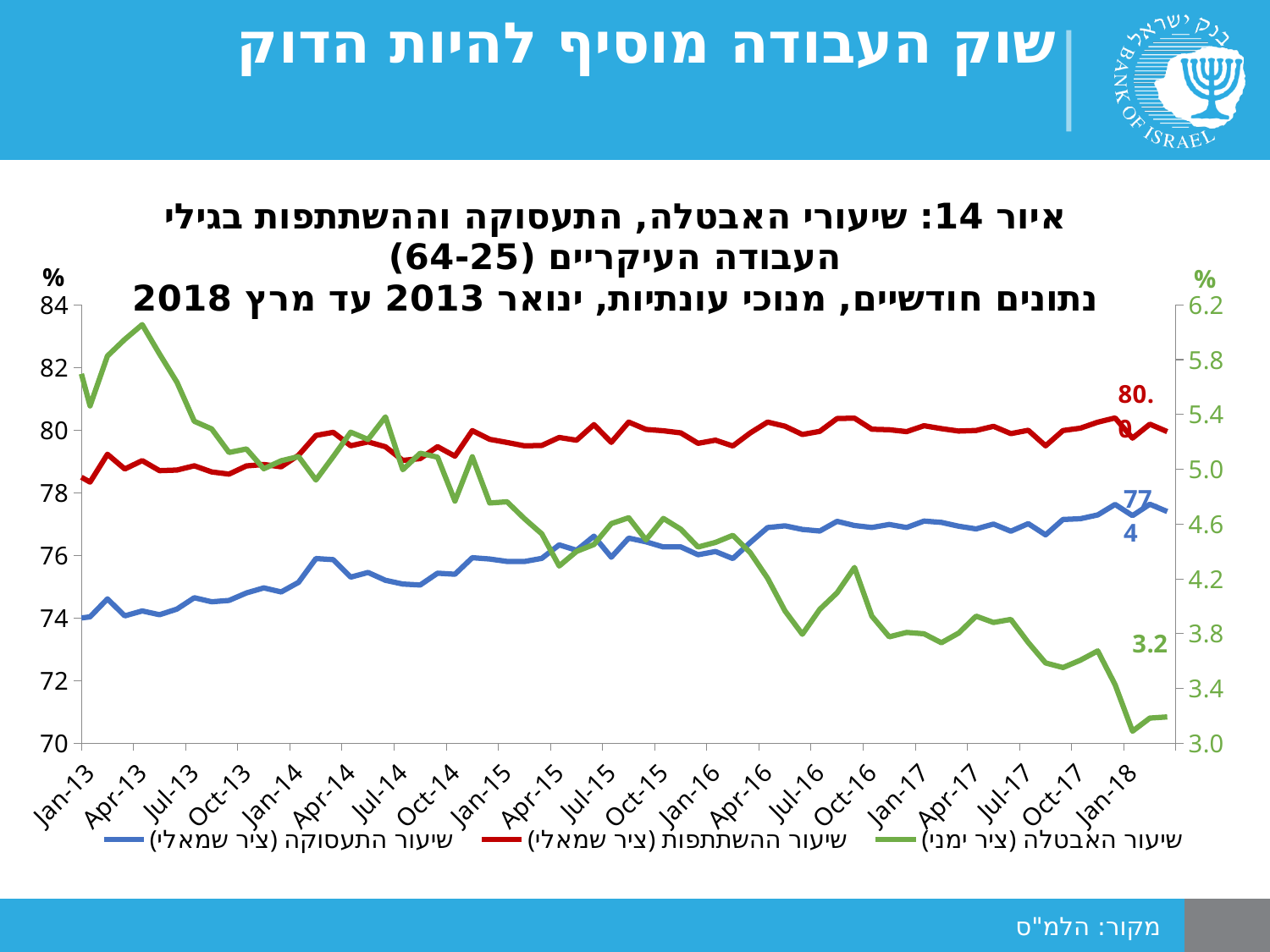
Which series is plotted on the right axis (ציר ימני)? שיעור האבטלה (unemployment rate) What kind of chart is shown on the slide? line chart What source is cited at the bottom of the slide? הלמ"ס Is the employment rate (blue line) at Jan-13 greater or less than 76 on the left axis? less Is the unemployment rate (green line) at Jan-18 greater or less than 3.4 on the right axis? less Does the unemployment rate (green line) rise or fall over the period from Jan-13 to 2018? fall At the end of the period, which is higher on the left axis: the employment rate or the participation rate? participation rate How many series does the legend list? 3 Is the unemployment rate (green line) at Jan-13 greater or less than 5.0 on the right axis? greater Does the employment rate (blue line) rise or fall over the period from Jan-13 to 2018? rise What is the last labelled value of the participation rate (שיעור ההשתתפות) series? 80.0 What is the last labelled value of the unemployment rate (שיעור האבטלה) series? 3.2